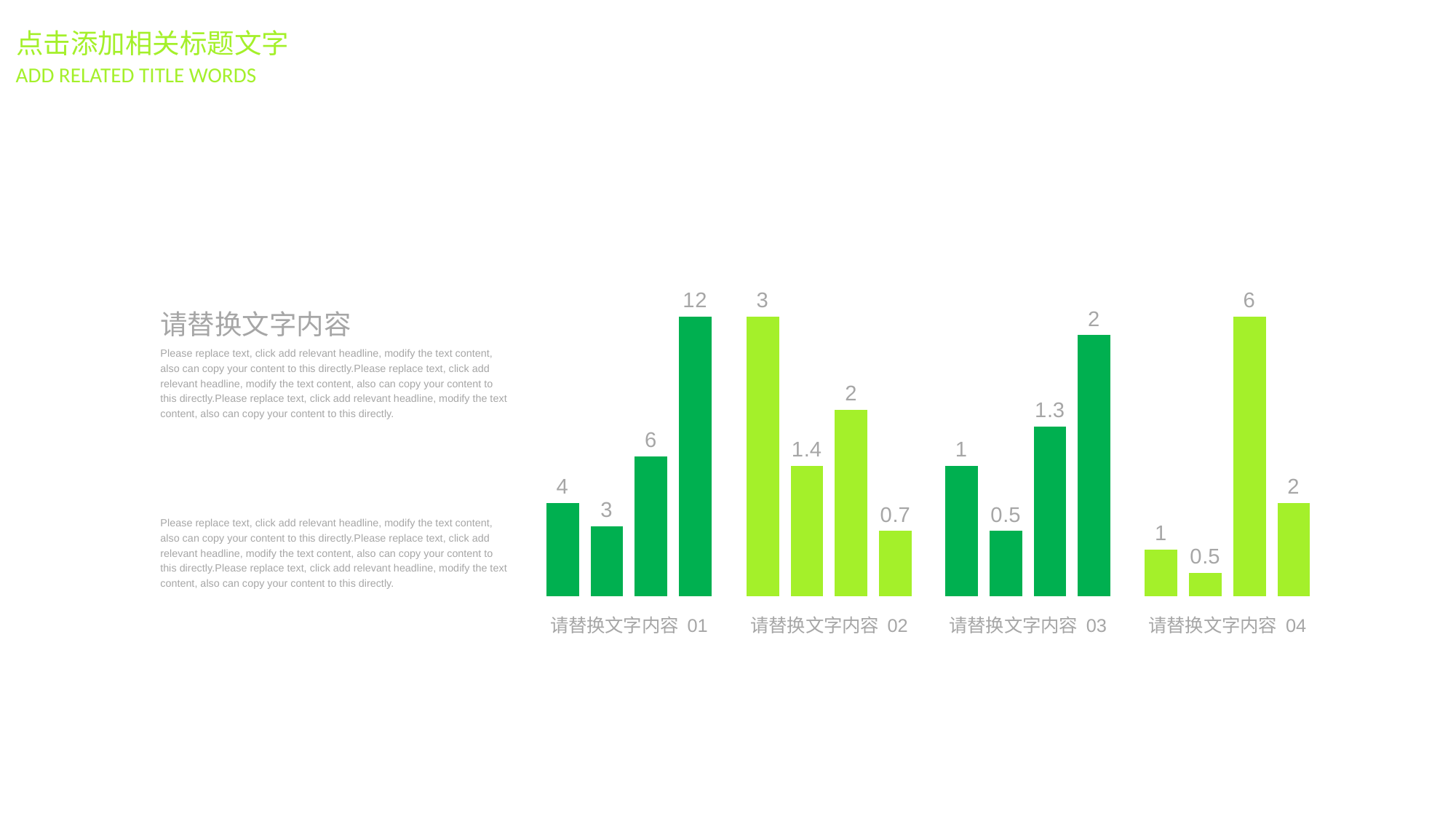
Which bar in the group labelled 请替换文字内容 02 has the lowest value? the fourth bar (0.7) What kind of chart is shown on the slide? bar chart How many labelled categories are shown along the bottom of the chart? 4 What is the value of the third bar in the group labelled 请替换文字内容 03? 1.3 What is the value of the smallest bar in the group labelled 请替换文字内容 04? 0.5 In the group labelled 请替换文字内容 03, which is larger: the first bar or the fourth bar? the fourth bar (2) What is the difference between the third bar (6) and the fourth bar (2) in the group labelled 请替换文字内容 04? 4 What colour are the bars in the group labelled 请替换文字内容 02? light green What is the value of the tallest bar in the group labelled 请替换文字内容 01? 12 What is the total of the four values in the group labelled 请替换文字内容 03? 4.8 What is the difference between the highest and lowest values in the group labelled 请替换文字内容 01? 9 What is the value of the first (leftmost) bar in the group labelled 请替换文字内容 02? 3